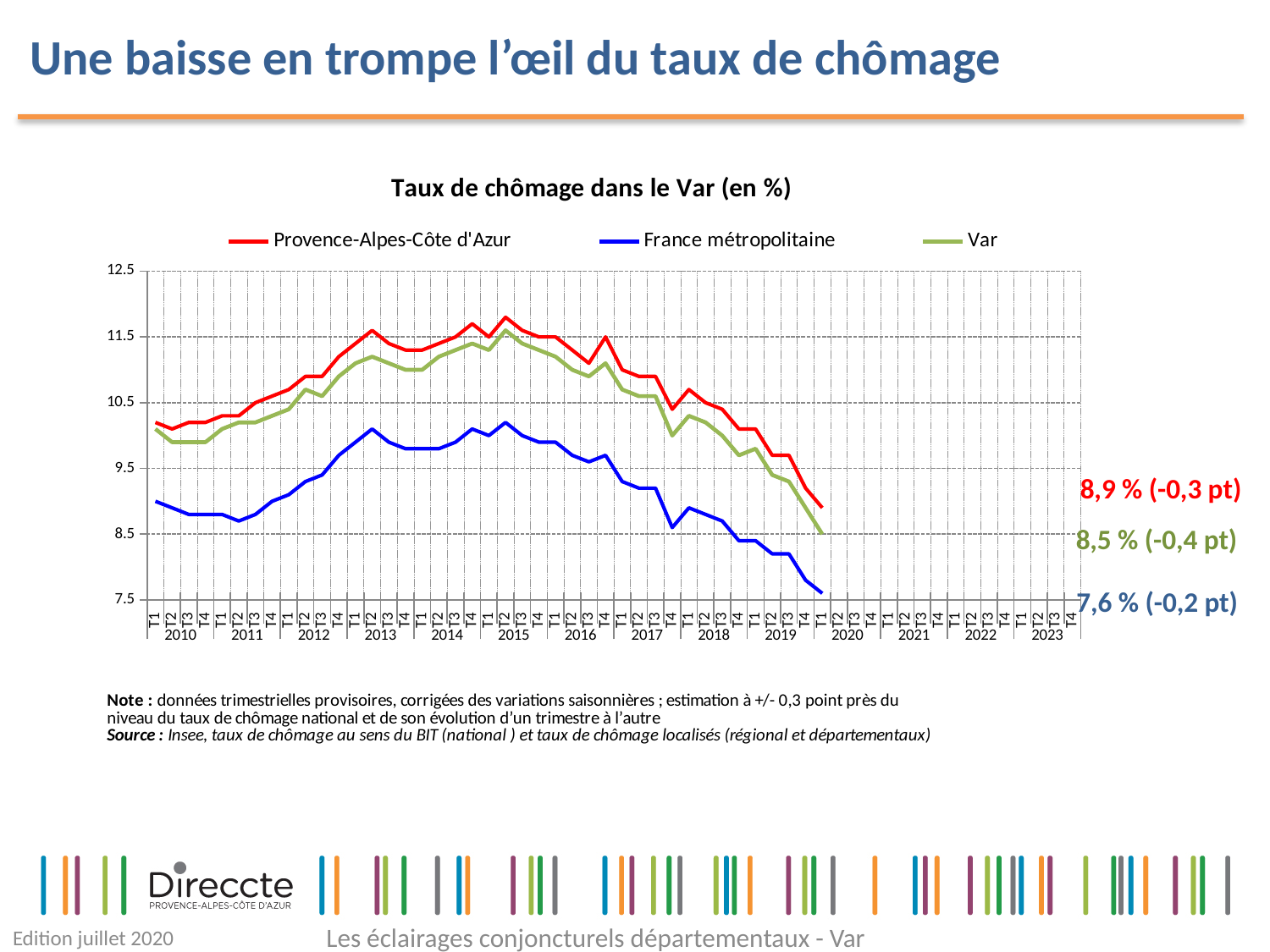
How many series does the legend list? 3 What kind of chart is shown on the slide? line chart Which series has the highest values across the whole period? Provence-Alpes-Côte d'Azur Is the value for France métropolitaine in T1 2010 greater or less than 9.5? less What is the latest unemployment rate shown for the Var? 8,5 % Do the unemployment rates rise or fall between 2017 and the start of 2020? fall What is the latest unemployment rate shown for Provence-Alpes-Côte d'Azur? 8,9 % What is the difference between the latest rates for Provence-Alpes-Côte d'Azur and the Var? 0,4 By how many points did the Var unemployment rate change in the latest quarter, according to the label? -0,4 pt Which series has the lowest values across the whole period? France métropolitaine What is the latest unemployment rate shown for France métropolitaine? 7,6 % What is the title of the chart? Taux de chômage dans le Var (en %)